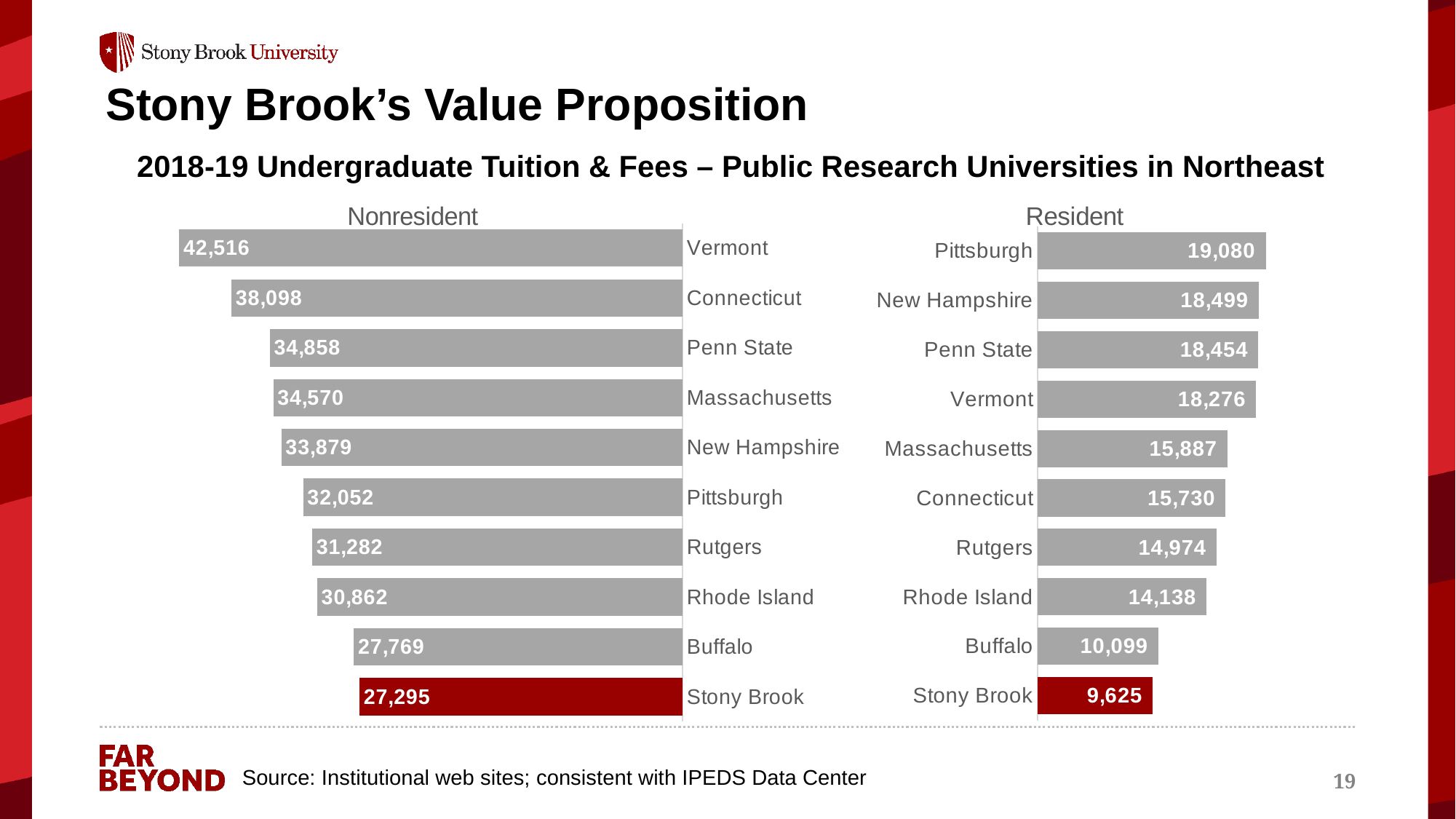
In the Nonresident chart, which university has the lowest tuition and fees? Stony Brook How many universities are shown in the Nonresident chart? 10 In the Nonresident chart, what is the difference between Buffalo and Stony Brook? 474 In the Resident chart, which is larger, the value for Rutgers or the value for Rhode Island? Rutgers Which university's bars are highlighted in red in both charts? Stony Brook In the Resident chart, which university has the highest tuition and fees? Pittsburgh In the Nonresident chart, what is the tuition and fees value for Vermont? 42,516 In the Resident chart, what is the difference between Pittsburgh and Stony Brook? 9,455 In the Resident chart, what is the tuition and fees value for Stony Brook? 9,625 In the Nonresident chart, what is the value for Stony Brook? 27,295 In the Resident chart, what is the value for New Hampshire? 18,499 What kind of chart is used for the Resident data? Bar chart